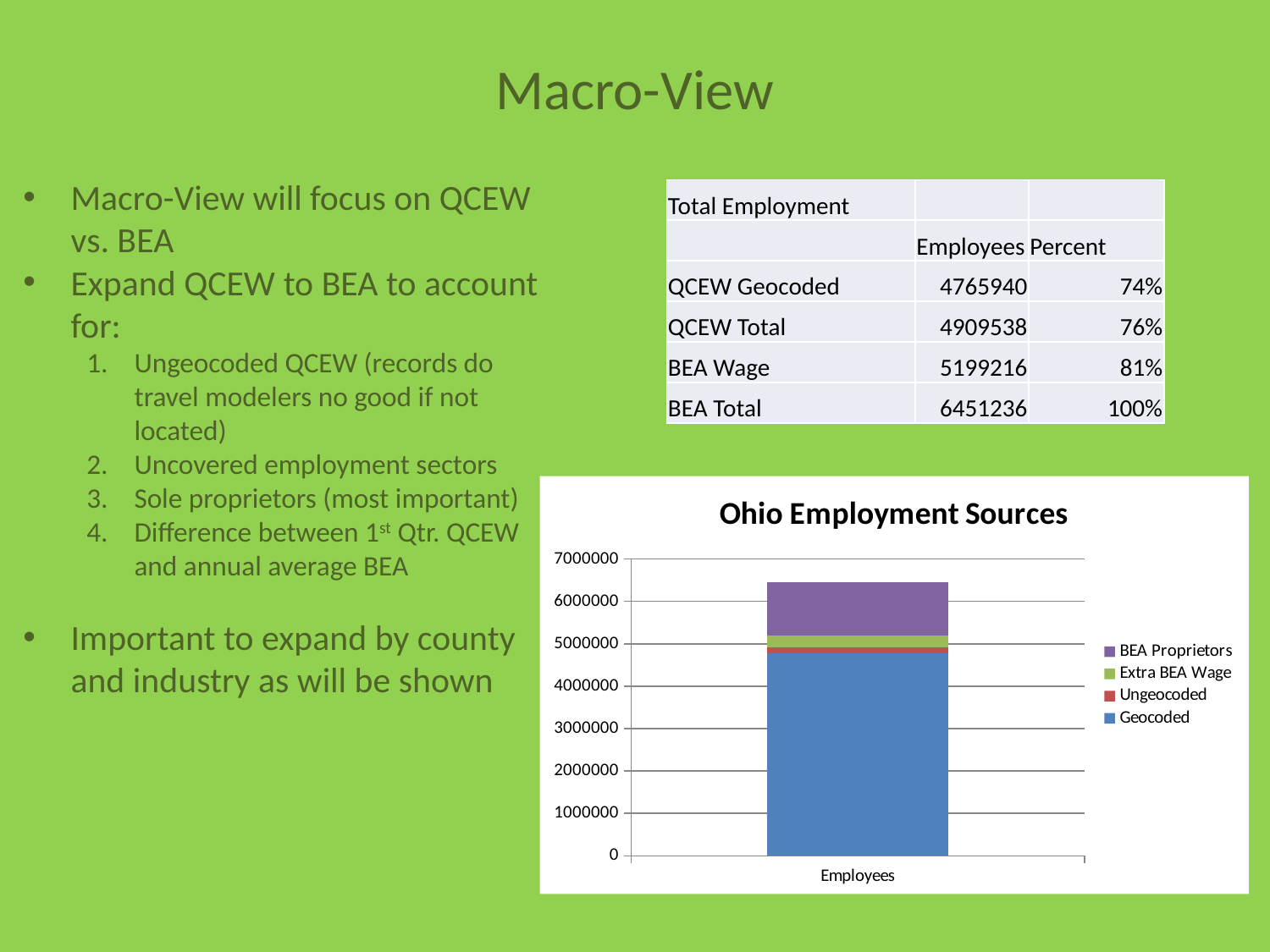
In the "Ohio Employment Sources" chart, is the Geocoded segment greater or less than 4000000? greater What is the title of the chart on the slide? Ohio Employment Sources In the "Ohio Employment Sources" chart, which series makes up the largest segment of the stacked bar? Geocoded In the "Ohio Employment Sources" chart, which segment is larger: BEA Proprietors or Extra BEA Wage? BEA Proprietors What kind of chart is the "Ohio Employment Sources" chart? bar chart What is the category label on the x axis of the "Ohio Employment Sources" chart? Employees How many series does the legend of the "Ohio Employment Sources" chart list? 4 How many categories are shown on the x axis of the "Ohio Employment Sources" chart? 1 In the "Ohio Employment Sources" chart, is the total height of the stacked bar greater or less than 7000000? less In the "Ohio Employment Sources" chart, is the total height of the stacked bar greater or less than 6000000? greater In the "Ohio Employment Sources" chart, which segment is larger: Geocoded or BEA Proprietors? Geocoded